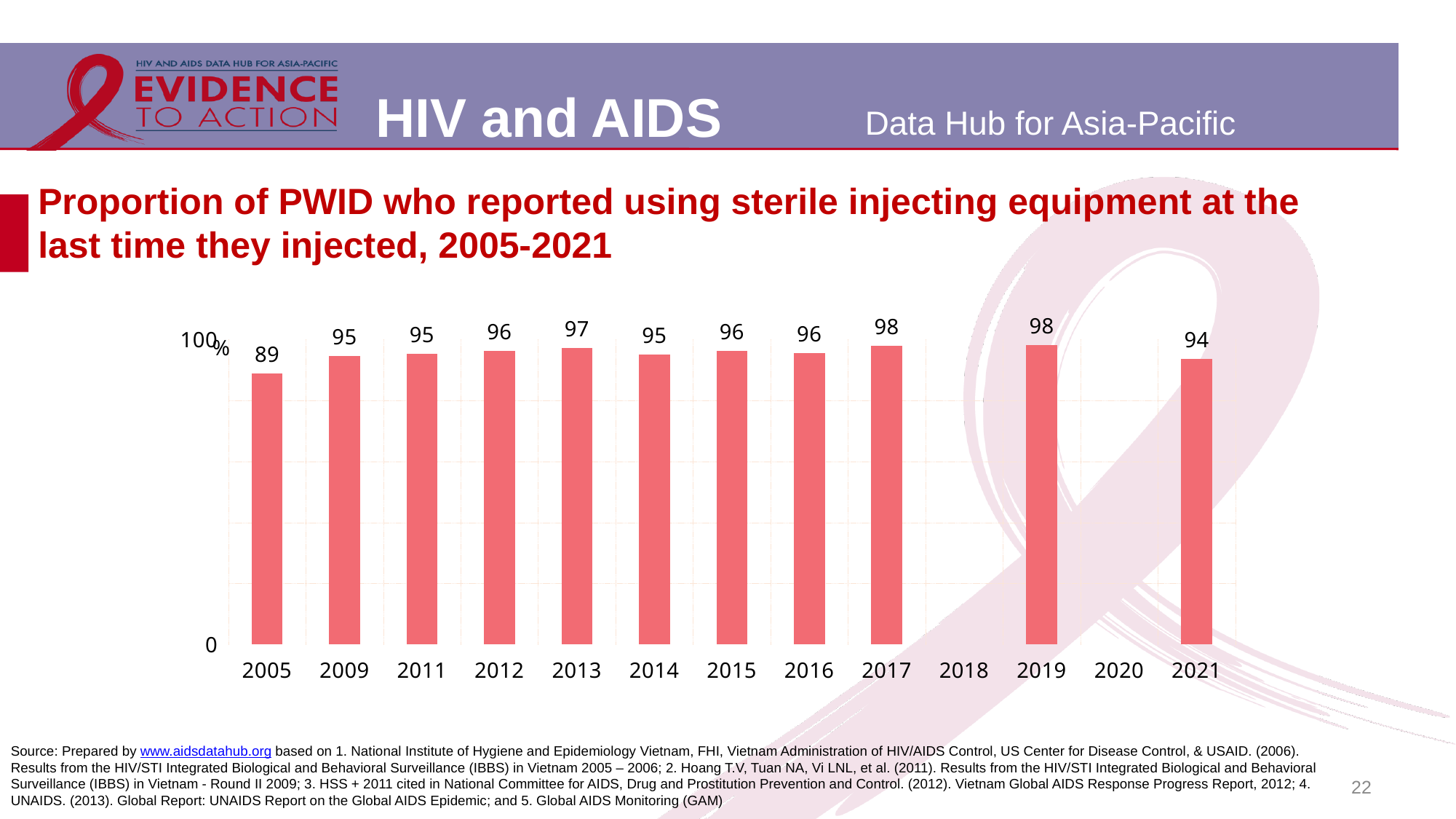
What is the value for 2013? 97 What kind of chart is shown on the slide? Bar chart How many bars are plotted on the chart? 11 What is the difference between the values for 2021 and 2005? 5 Do the values generally rise or fall from 2005 to 2017? Rise What is the highest value shown on the chart? 98 What is the difference between the values for 2017 and 2005? 9 Which year has the lowest value? 2005 What is the value for 2021? 94 What is the value for 2005? 89 Which is larger, the value for 2013 or the value for 2014? 2013 What is the value for 2017? 98